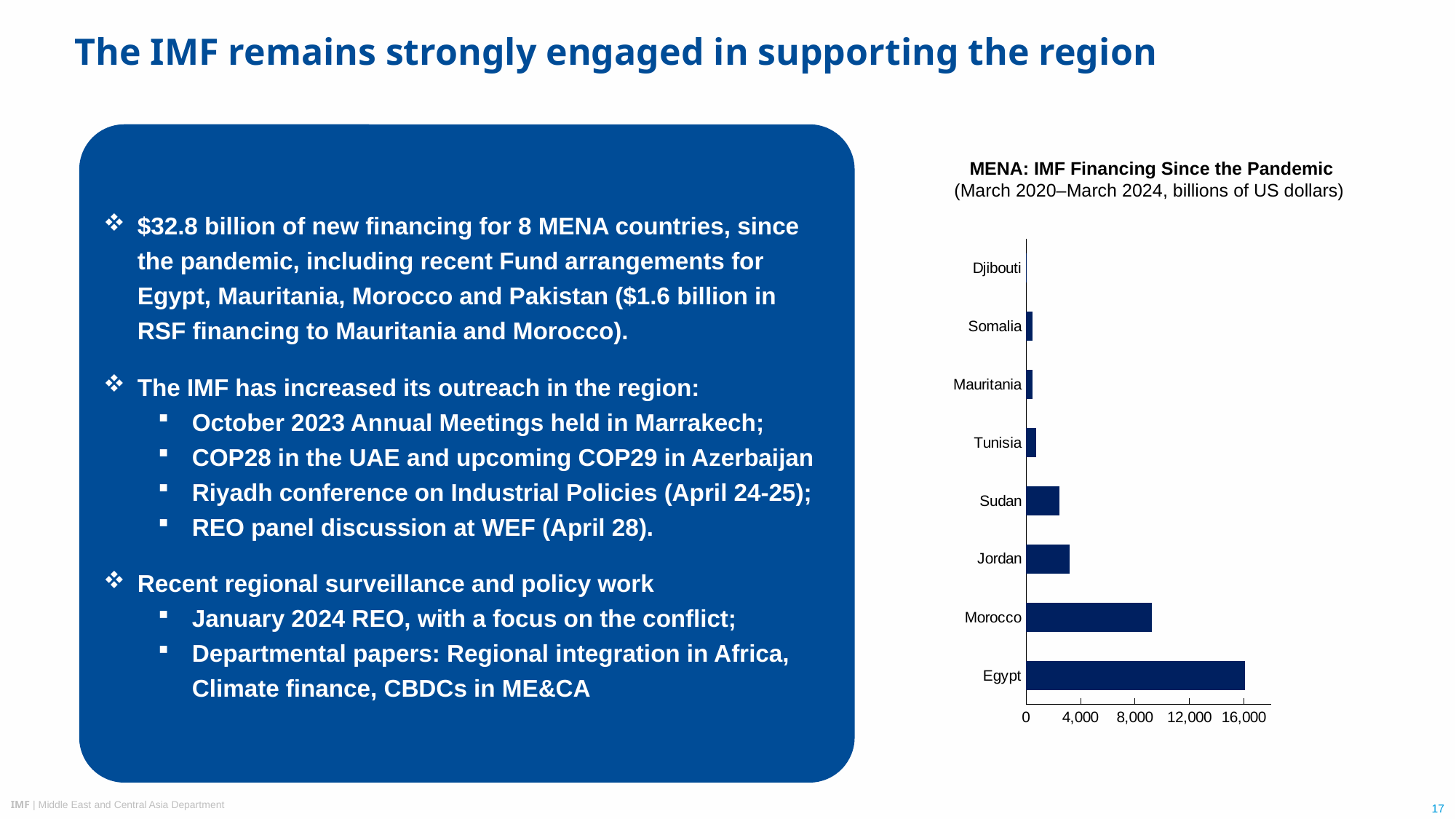
Is the value for Jordan greater or less than 4,000? less Is the value for Morocco greater or less than 8,000? greater Which received more IMF financing, Jordan or Sudan? Jordan Which country received the most IMF financing according to the chart? Egypt Which received more IMF financing, Egypt or Morocco? Egypt Which country received the least IMF financing according to the chart? Djibouti What period does the chart cover, according to its subtitle? March 2020–March 2024 What kind of chart is shown on the slide? Bar chart What is the title of the chart? MENA: IMF Financing Since the Pandemic Which received more IMF financing, Morocco or Jordan? Morocco Is the value for Egypt greater or less than 12,000? greater How many countries are shown in the chart? 8